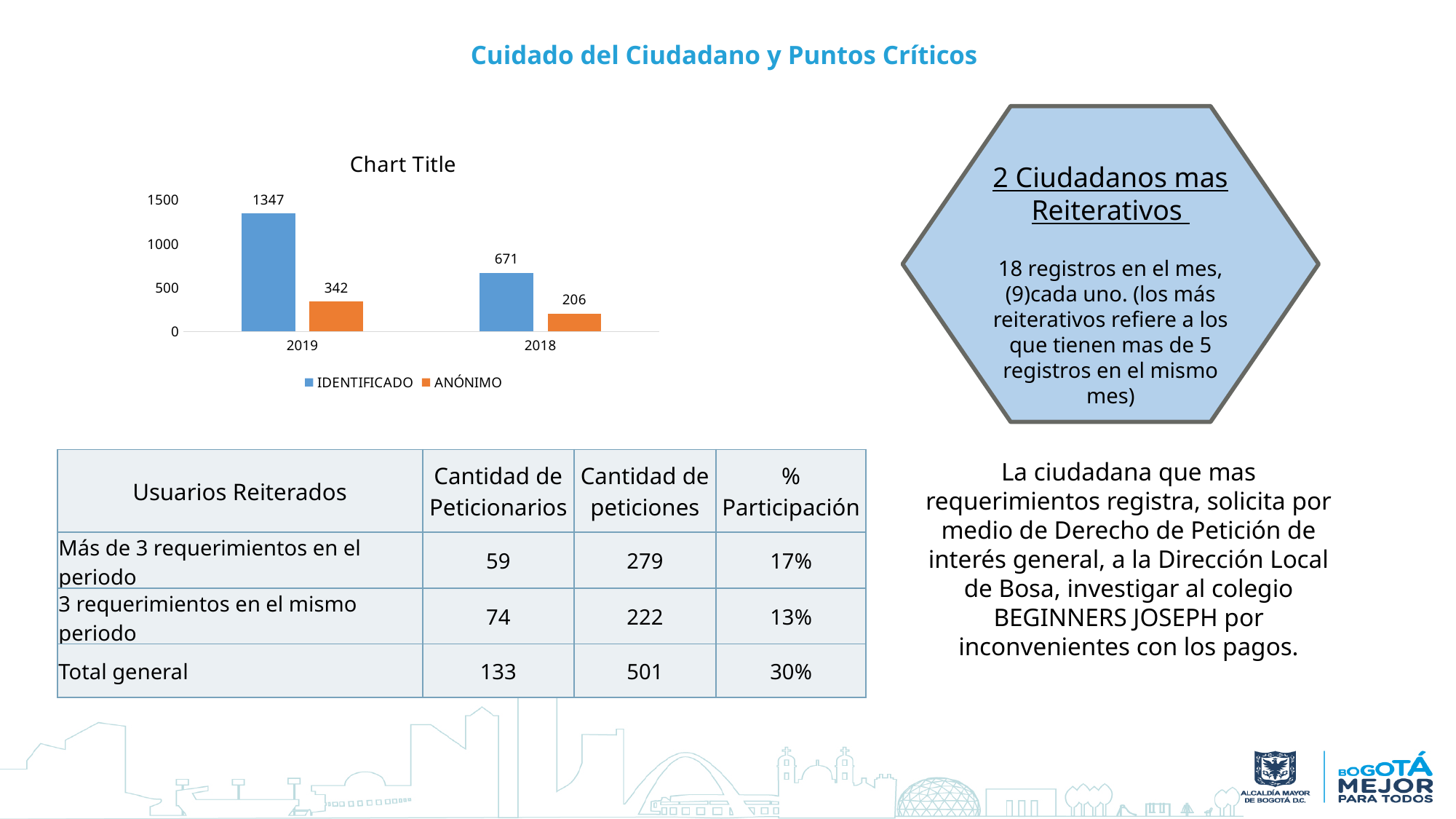
What is the value for IDENTIFICADO in 2019? 1347 What is the value for ANÓNIMO in 2019? 342 Which year has the highest IDENTIFICADO value? 2019 Which year has the lowest ANÓNIMO value? 2018 Which is larger: ANÓNIMO in 2019 or IDENTIFICADO in 2018? IDENTIFICADO in 2018 What colour represents the ANÓNIMO series? Orange What is the difference between the IDENTIFICADO values for 2019 and 2018? 676 What is the value for IDENTIFICADO in 2018? 671 What kind of chart is shown? Bar chart How many categories are shown on the x axis? 2 What is the value for ANÓNIMO in 2018? 206 How many series does the legend list? 2